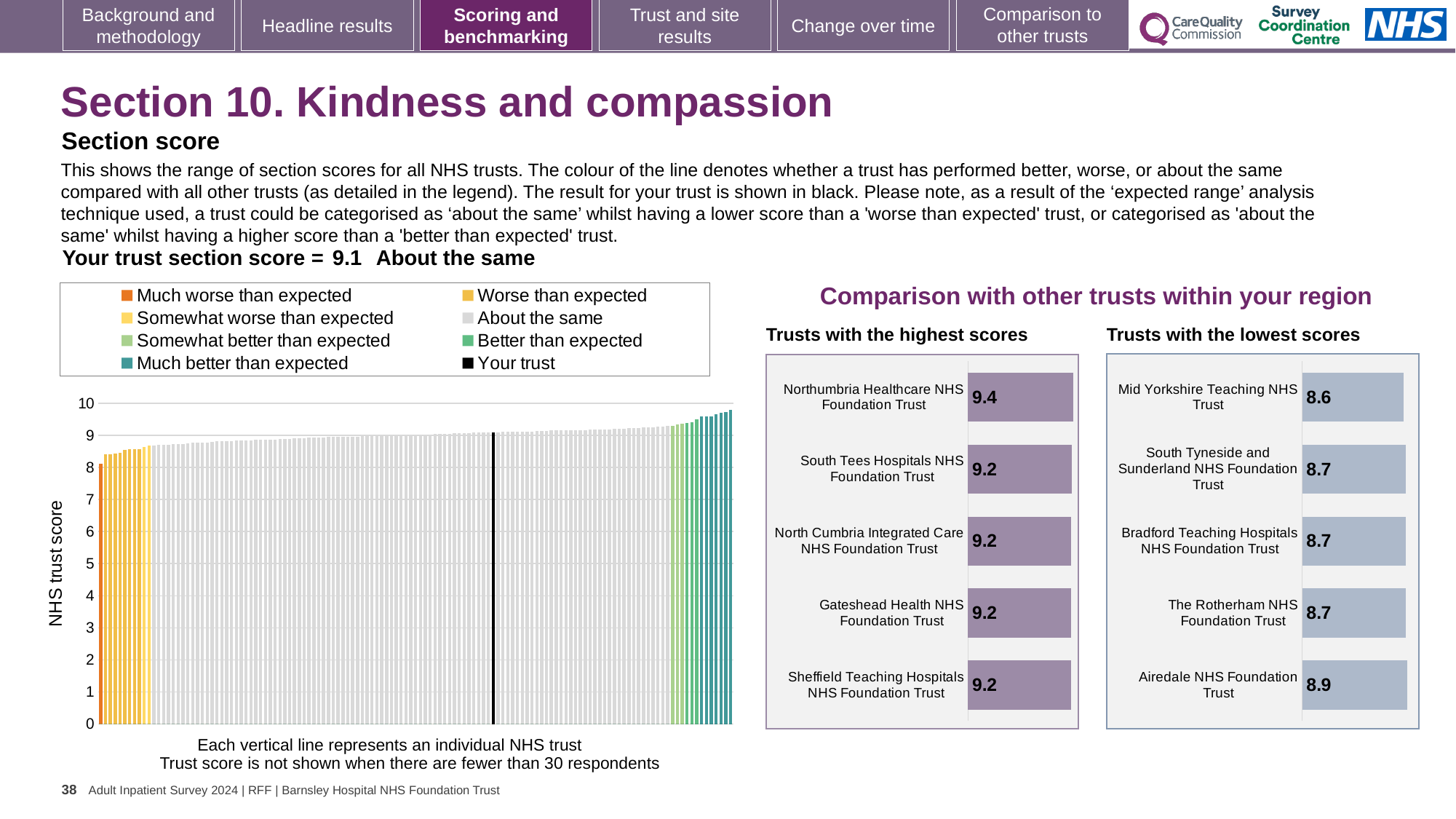
In the main chart on the left, do the trust scores rise or fall from left to right along the x axis? Rise In the 'Trusts with the highest scores' chart, what is the score for Northumbria Healthcare NHS Foundation Trust? 9.4 In the 'Trusts with the highest scores' chart, what is the difference between the scores of Northumbria Healthcare NHS Foundation Trust and Sheffield Teaching Hospitals NHS Foundation Trust? 0.2 In the 'Trusts with the lowest scores' chart, what is the difference between the scores of Airedale NHS Foundation Trust and Mid Yorkshire Teaching NHS Trust? 0.3 How many trusts are listed in the 'Trusts with the lowest scores' chart? 5 Which is larger: the score for Gateshead Health NHS Foundation Trust in the highest scores chart or the score for Bradford Teaching Hospitals NHS Foundation Trust in the lowest scores chart? Gateshead Health NHS Foundation Trust In the 'Trusts with the lowest scores' chart, what is the score for Airedale NHS Foundation Trust? 8.9 In the 'Trusts with the lowest scores' chart, which trust has the lowest score? Mid Yorkshire Teaching NHS Trust What kind of chart is the main chart on the left showing NHS trust scores? Bar chart In the main chart on the left showing all NHS trusts, what is the section score for your trust? 9.1 How many entries does the legend of the main chart on the left list? 8 In the 'Trusts with the highest scores' chart, which trust has the highest score? Northumbria Healthcare NHS Foundation Trust